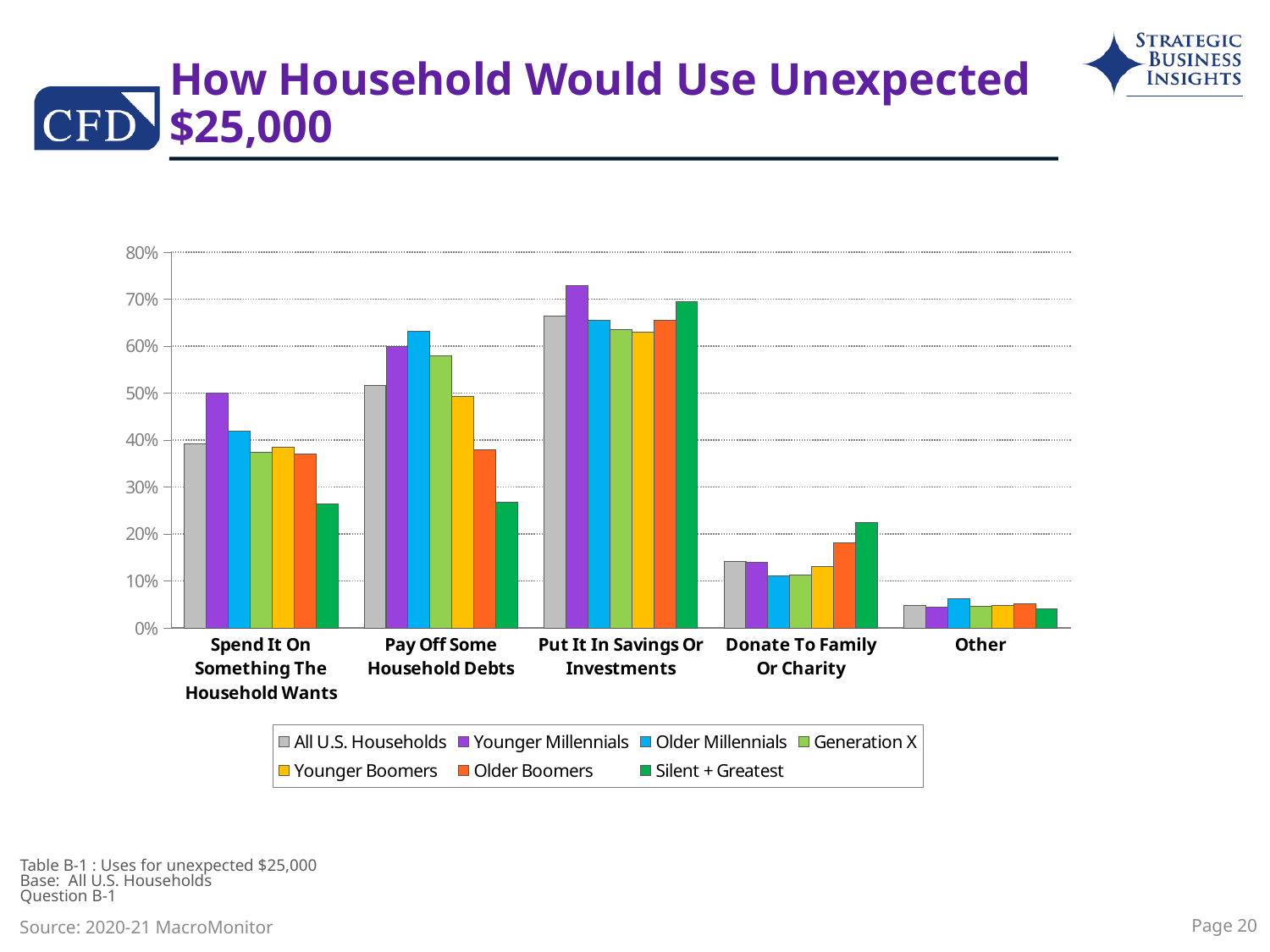
Which series has the lowest bar in the Pay Off Some Household Debts category? Silent + Greatest In the Spend It On Something The Household Wants category, which is larger: Younger Millennials or Silent + Greatest? Younger Millennials Is the value for Younger Millennials in the Put It In Savings Or Investments category greater or less than 70%? greater Which series has the highest bar in the Put It In Savings Or Investments category? Younger Millennials What kind of chart is shown on the slide? bar chart Is the value for Silent + Greatest in the Spend It On Something The Household Wants category greater or less than 30%? less In the Pay Off Some Household Debts category, which is larger: Older Millennials or Older Boomers? Older Millennials How many categories are shown along the x axis of the chart? 5 Is the value for Older Boomers in the Pay Off Some Household Debts category greater or less than 50%? less Which series has the highest bar in the Donate To Family Or Charity category? Silent + Greatest How many series does the chart's legend list? 7 For All U.S. Households, which category has the highest bar? Put It In Savings Or Investments